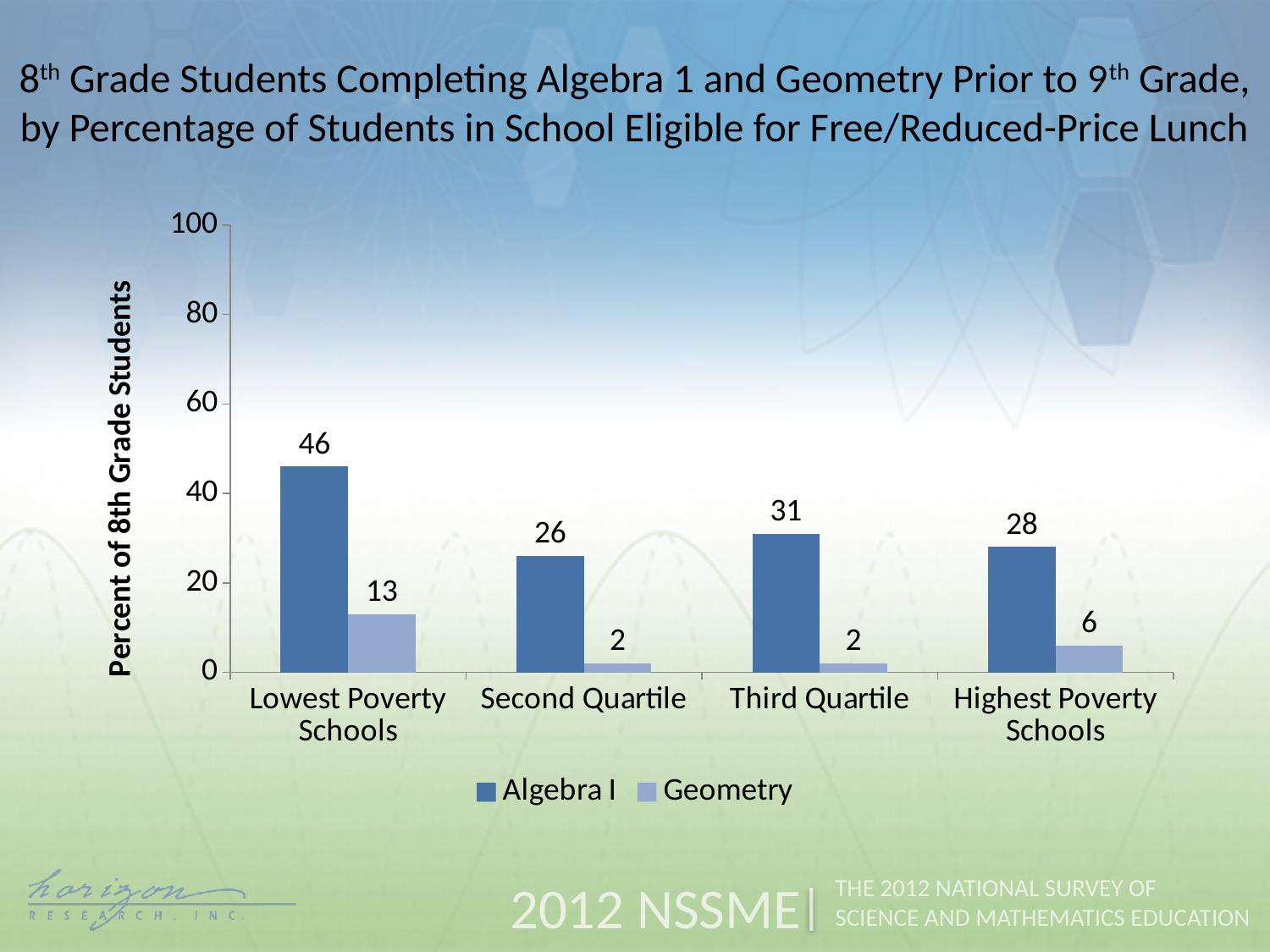
Which is larger, the Algebra I value for Third Quartile or for Highest Poverty Schools? Third Quartile What is the label of the y axis? Percent of 8th Grade Students How many series does the legend list? 2 How many categories are shown on the x axis? 4 What kind of chart is shown on the slide? Bar chart Which category has the lowest Algebra I value? Second Quartile What is the Algebra I value for Third Quartile? 31 What is the difference between the Algebra I and Geometry values for Lowest Poverty Schools? 33 Is the Algebra I value for Lowest Poverty Schools greater or less than 40? greater What is the Geometry value for Highest Poverty Schools? 6 What is the Algebra I value for Lowest Poverty Schools? 46 Which category has the highest Algebra I value? Lowest Poverty Schools